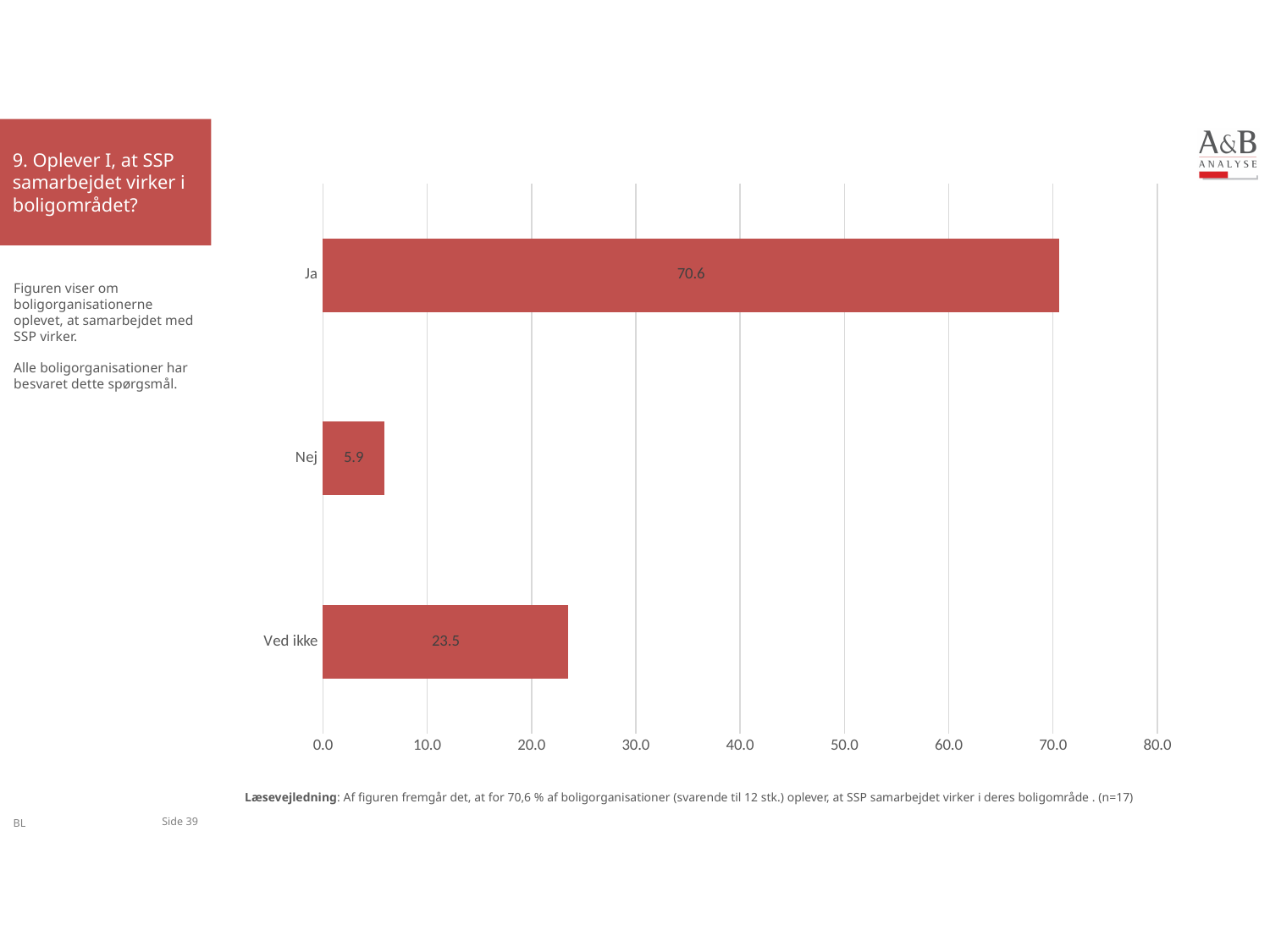
What is the value for "Ved ikke"? 23.5 Which category has the highest value? Ja Is the value for "Ja" greater or less than 60.0? greater What kind of chart is shown on the slide? bar chart What is the highest value shown on the x axis? 80.0 What is the value for "Nej"? 5.9 What is the difference between the values for "Ved ikke" and "Nej"? 17.6 What is the difference between the values for "Ja" and "Ved ikke"? 47.1 Which is larger, the value for "Ved ikke" or the value for "Nej"? Ved ikke How many categories are shown in the chart? 3 Which category has the lowest value? Nej What is the value for "Ja"? 70.6